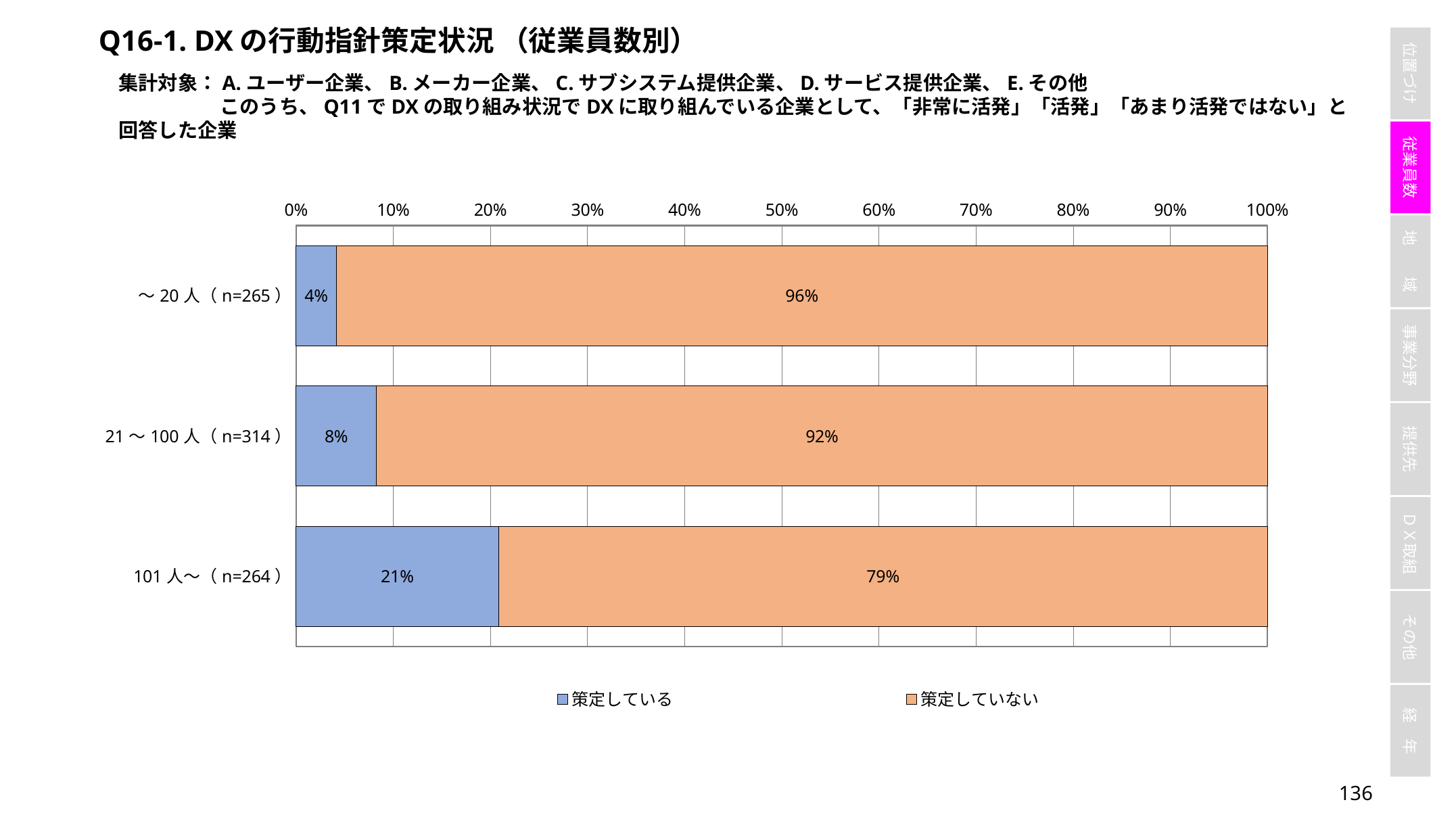
What kind of chart is shown on the slide? Stacked bar chart How many series does the legend list? 2 What is the value of 策定している for 101人〜（n=264）? 21% What is the difference between the 策定している values for 101人〜（n=264） and 〜20人（n=265）? 17% What is the total of the stacked bar for 21〜100人（n=314）? 100% What is the value of 策定している for 〜20人（n=265）? 4% What is the value of 策定していない for 21〜100人（n=314）? 92% Which employee-size category has the highest value for 策定している? 101人〜（n=264） Which is larger: 策定している for 21〜100人（n=314） or for 〜20人（n=265）? 21〜100人（n=314） Which employee-size category has the lowest value for 策定していない? 101人〜（n=264） How many employee-size categories are shown in the chart? 3 Is the value of 策定していない for 101人〜（n=264） greater or less than 70%? greater